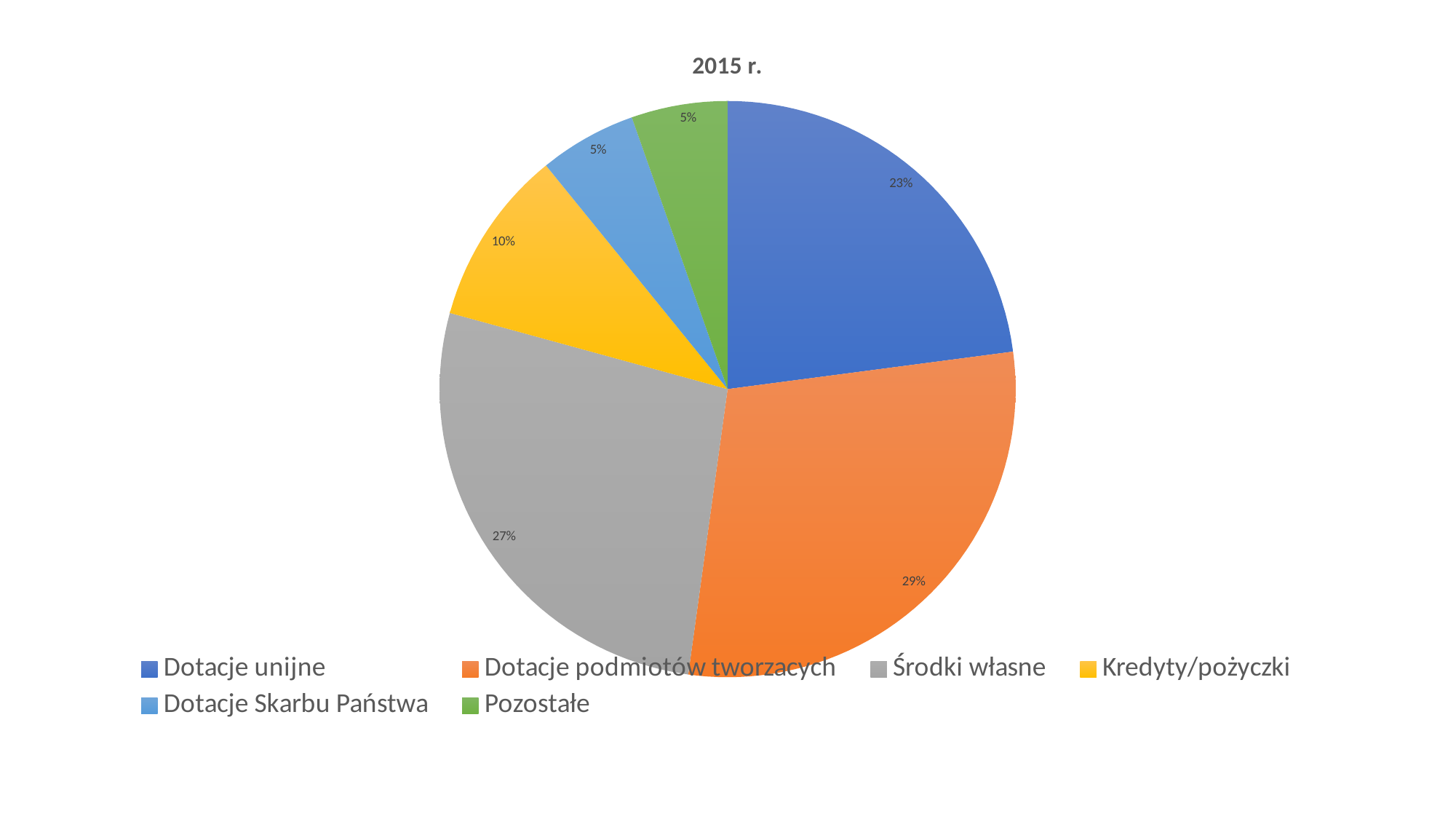
What is the difference in percentage points between the share for Dotacje podmiotów tworzących and the share for Dotacje unijne? 6 What share of the pie does Dotacje unijne have? 23% What share of the pie does Kredyty/pożyczki have? 10% What share of the pie does Dotacje podmiotów tworzących have? 29% Which category has the largest slice of the pie? Dotacje podmiotów tworzących What is the title of the chart? 2015 r. Which is larger, the share for Środki własne or the share for Dotacje unijne? Środki własne How many categories does the pie chart show? 6 What colour is the slice for Kredyty/pożyczki? yellow What kind of chart is shown on the slide? pie chart